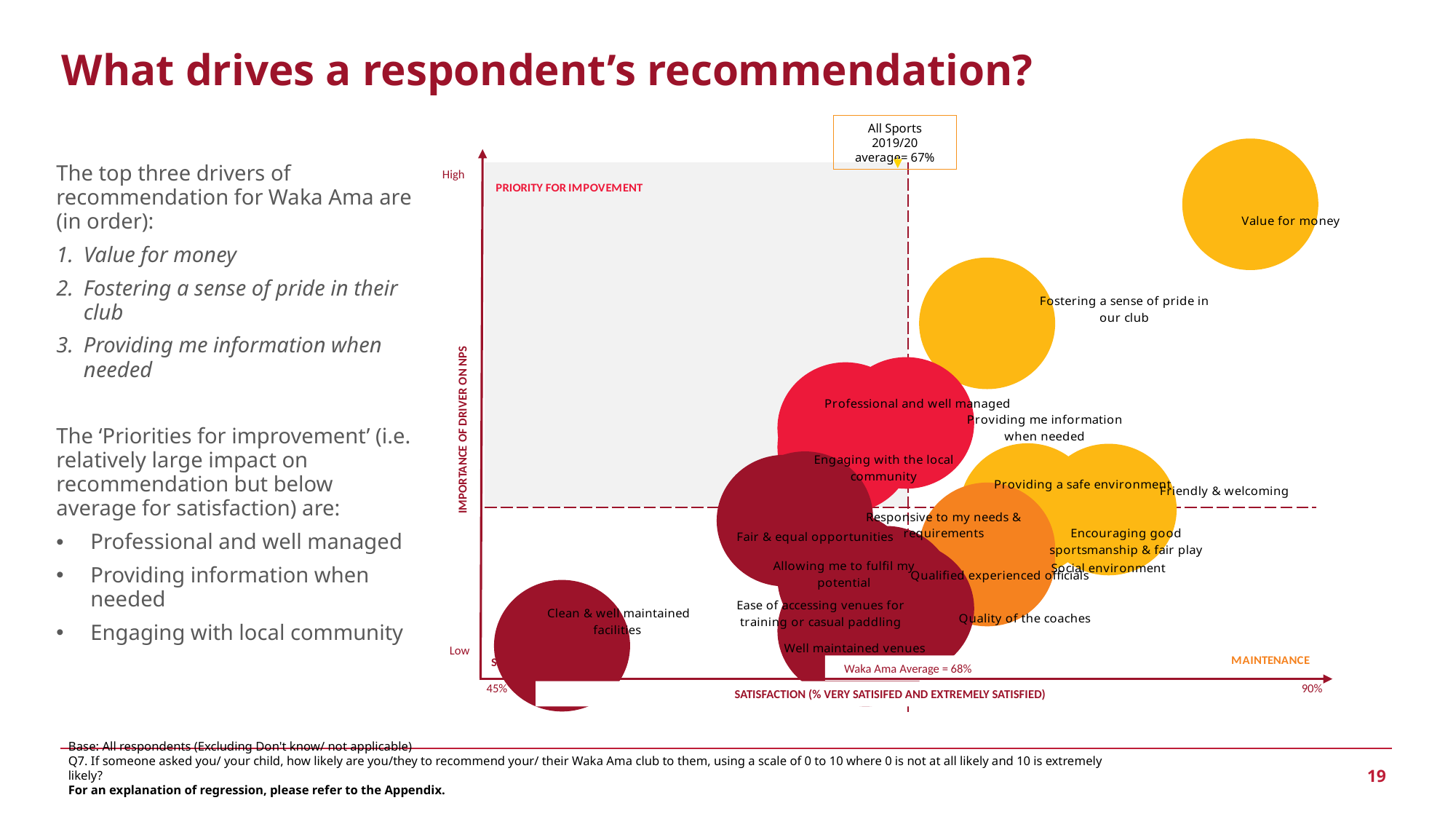
Which has higher importance on NPS: Value for money or Fostering a sense of pride in our club? Value for money What is the All Sports 2019/20 average shown on the chart? 67% Which driver has the lowest satisfaction score in the chart? Clean & well maintained facilities Which driver has the highest satisfaction score in the chart? Value for money What kind of chart is shown on the slide? Bubble chart What is the Waka Ama average satisfaction shown on the chart? 68% Is the satisfaction value for Clean & well maintained facilities greater or less than the Waka Ama average of 68%? less Which driver has the highest importance on NPS in the chart? Value for money What is the label of the horizontal axis of the chart? SATISFACTION (% VERY SATISIFED AND EXTREMELY SATISFIED) Is the satisfaction value for Value for money greater or less than the Waka Ama average of 68%? greater What is the label of the vertical axis of the chart? IMPORTANCE OF DRIVER ON NPS